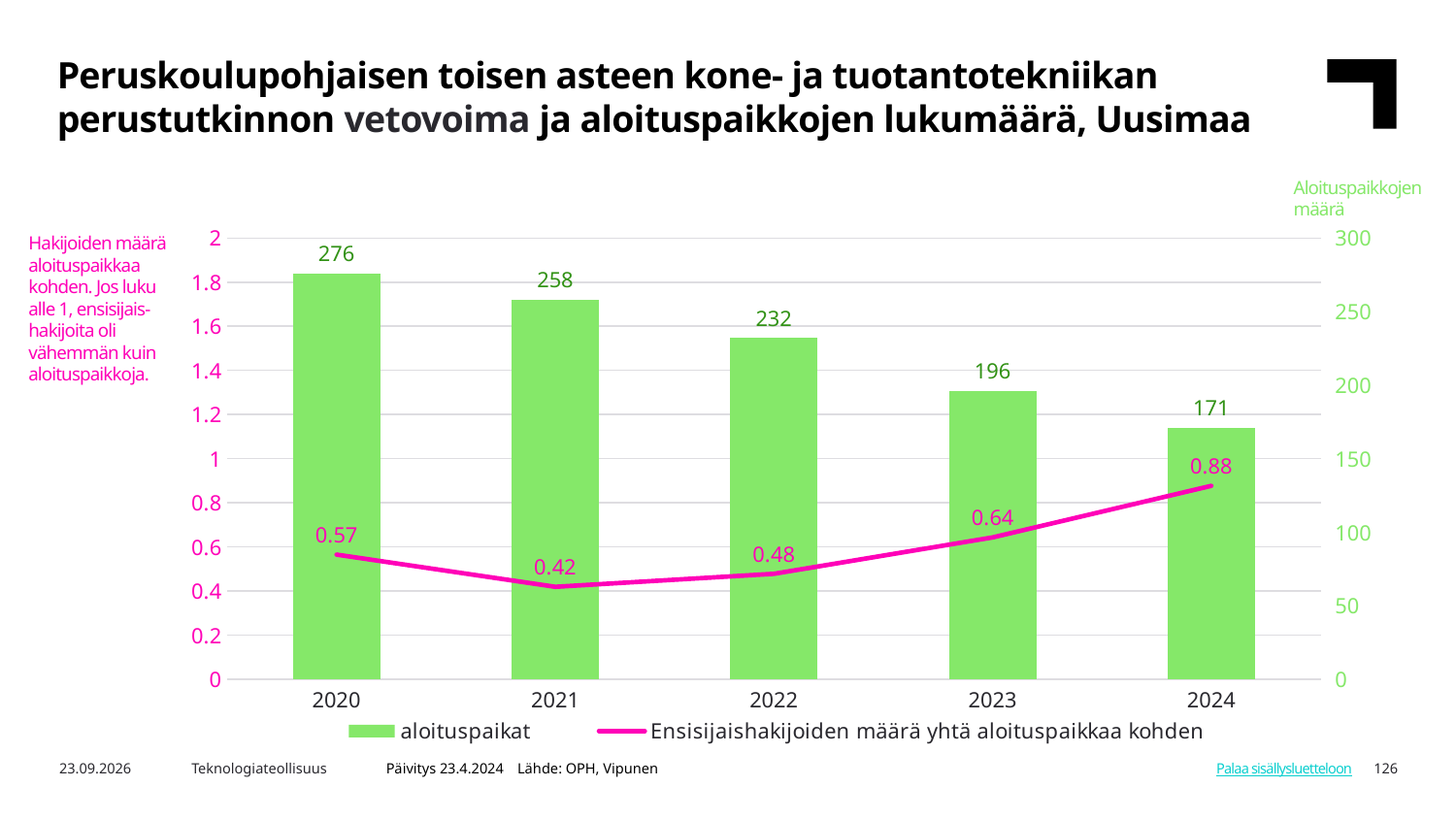
Which is larger, the Ensisijaishakijoiden määrä yhtä aloituspaikkaa kohden value for 2023 or for 2024? 2024 What kind of chart is shown on the slide? Combined bar and line chart Which year has the lowest value of Ensisijaishakijoiden määrä yhtä aloituspaikkaa kohden? 2021 What is the value of Ensisijaishakijoiden määrä yhtä aloituspaikkaa kohden for 2021? 0.42 What is the value of Ensisijaishakijoiden määrä yhtä aloituspaikkaa kohden for 2024? 0.88 How many series does the legend list? 2 How many years are shown on the x axis? 5 Which year has the highest value of aloituspaikat? 2020 Do the aloituspaikat values rise or fall from 2020 to 2024? Fall What is the difference in aloituspaikat between 2020 and 2024? 105 What colour are the aloituspaikat bars? Green What is the value of aloituspaikat for 2022? 232